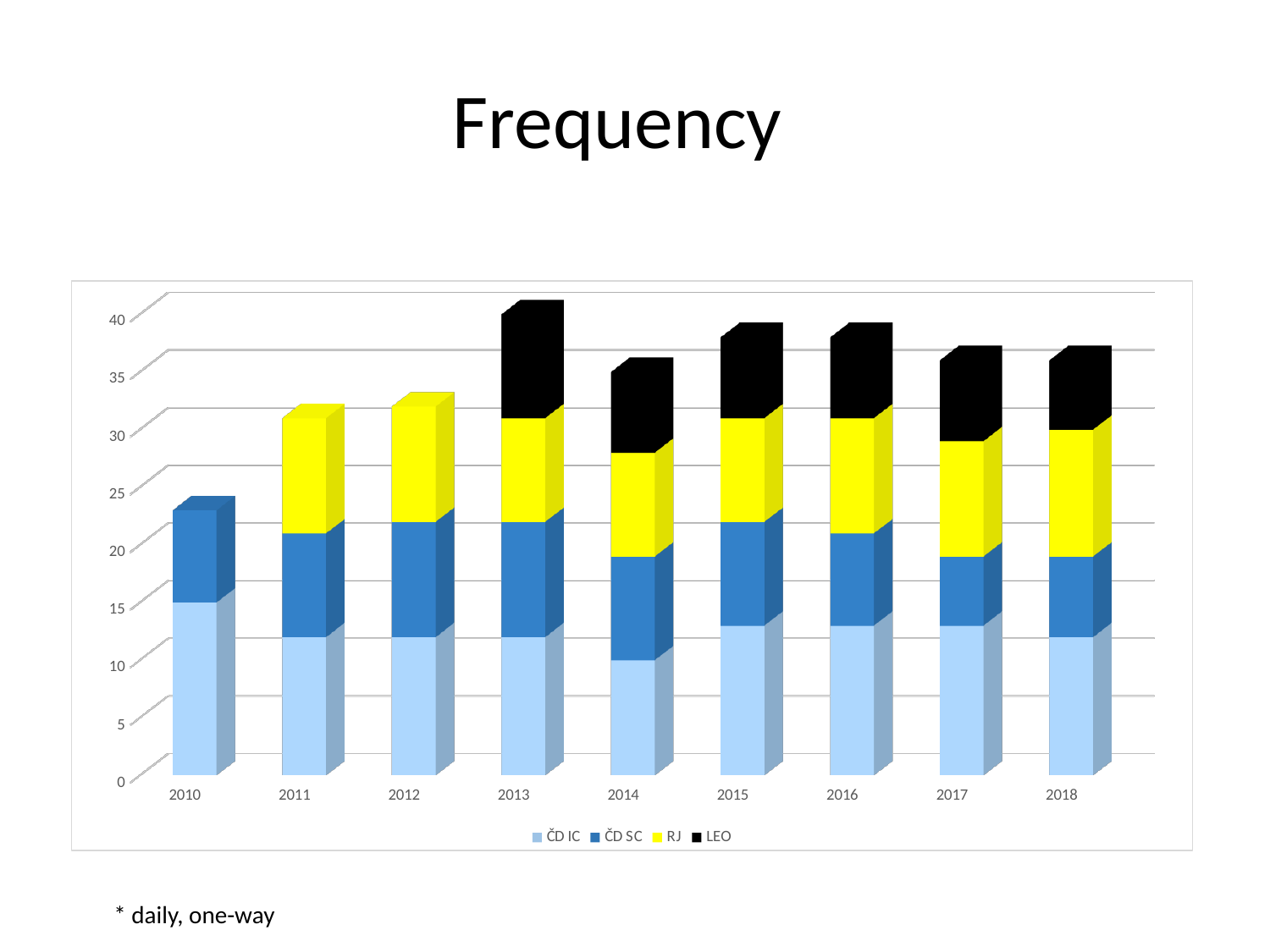
Which year has the larger total bar, 2010 or 2011? 2011 Is the total value for 2010 greater or less than 25? less How many years are shown on the x axis of the chart? 9 Which year has the highest total stacked bar? 2013 What is the title of the slide containing the chart? Frequency What kind of chart is shown on the slide? Stacked bar chart Is the total value for 2014 greater or less than 30? greater Is the ČD IC value for 2014 greater or less than 15? less In which year does the LEO series first appear in the chart? 2013 How many series does the chart legend list? 4 Which year has the lowest total stacked bar? 2010